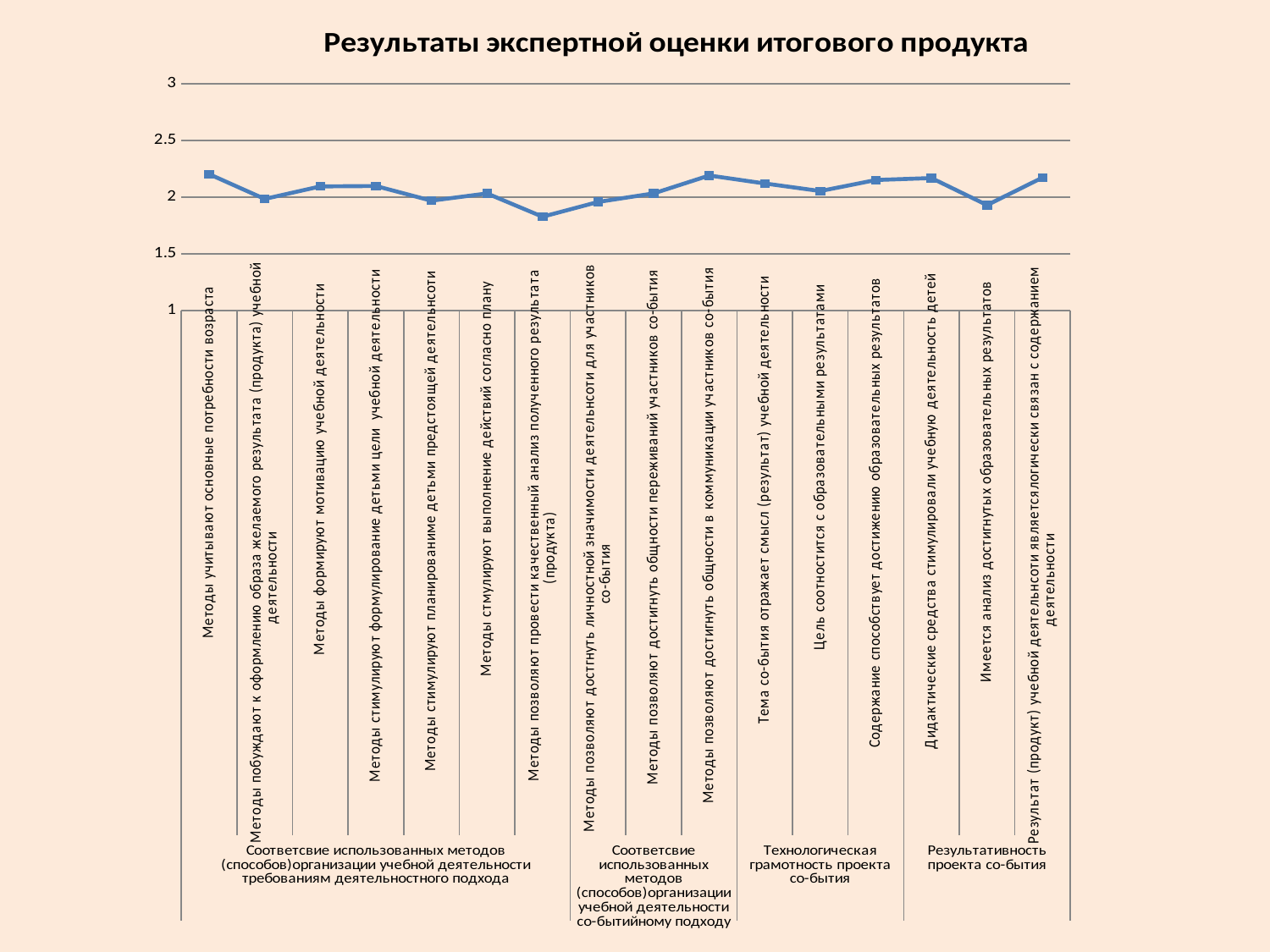
How many data points are plotted on the line? 16 What is the title of the chart? Результаты экспертной оценки итогового продукта Is the value for 'Методы учитывают основные потребности возраста' greater or less than 2? greater Is the value for 'Имеется анализ достигнутых образовательных результатов' greater or less than 2? less Which category has the lowest value on the chart? Методы позволяют провести качественный анализ полученного результата (продукта) How many category groups are labelled along the bottom of the chart? 4 What kind of chart is shown on the slide? line chart Is the value for 'Методы позволяют провести качественный анализ полученного результата (продукта)' greater or less than 2? less Which is larger: the value for 'Методы позволяют достигнуть общности в коммуникации участников со-бытия' or the value for 'Имеется анализ достигнутых образовательных результатов'? Методы позволяют достигнуть общности в коммуникации участников со-бытия Which is larger: the value for 'Методы учитывают основные потребности возраста' or the value for 'Методы позволяют провести качественный анализ полученного результата (продукта)'? Методы учитывают основные потребности возраста Do the values rise or fall from 'Методы позволяют достигнуть общности в коммуникации участников со-бытия' to 'Цель соотностится с образовательными результатами'? fall